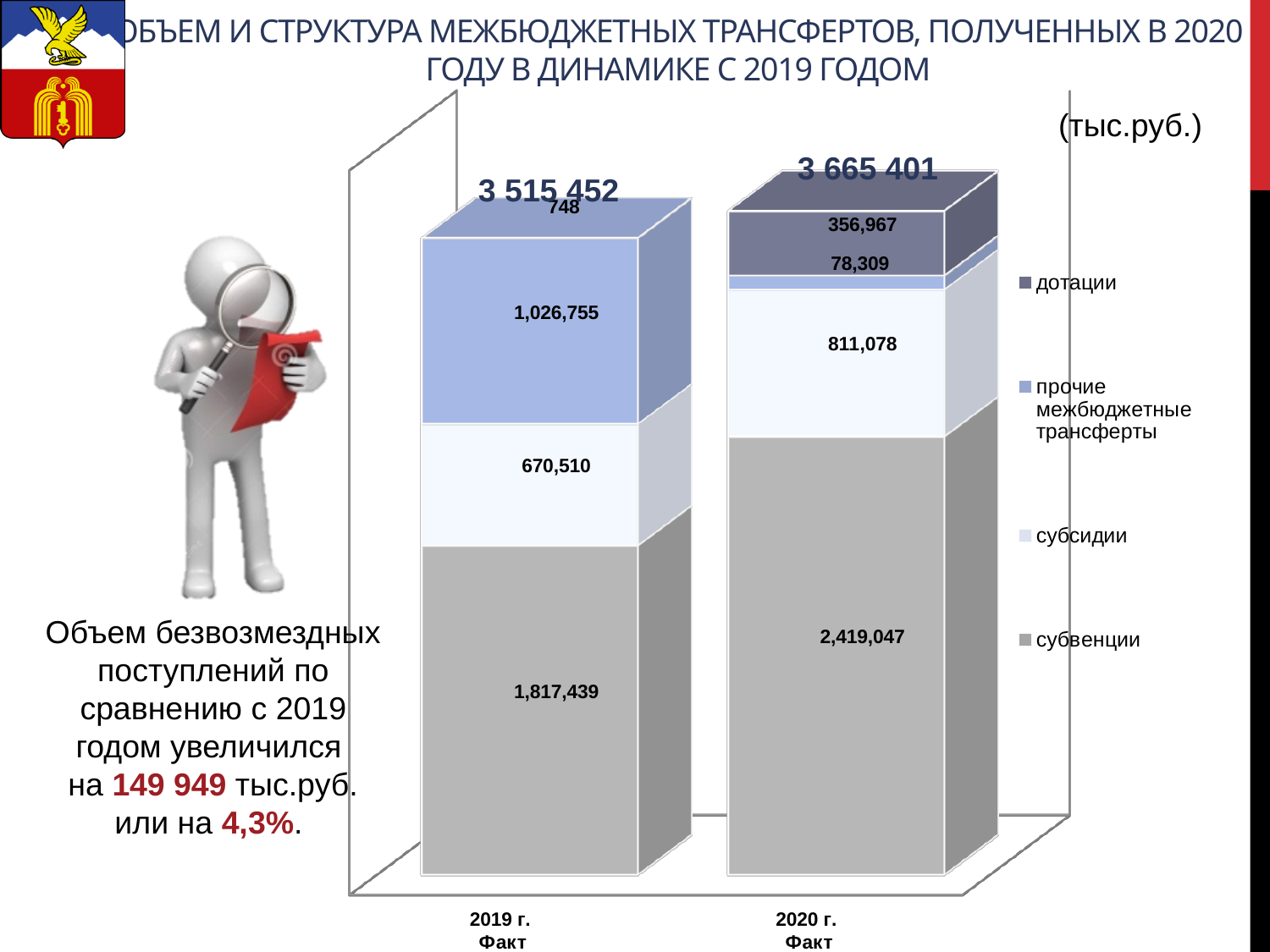
What type of chart is shown on the slide? stacked bar chart Which series has the largest value in the 2020 г. Факт bar? субвенции Which series has the smallest value in the 2019 г. Факт bar? дотации How many categories (bars) are shown on the x axis? 2 What is the value of субсидии for 2020 г. Факт? 811,078 What is the difference between the субвенции values for 2020 г. Факт and 2019 г. Факт? 601,608 What is the total of the stacked bar for 2020 г. Факт? 3 665 401 How many series does the legend list? 4 What is the value of прочие межбюджетные трансферты for 2019 г. Факт? 1,026,755 What is the value of субвенции for 2019 г. Факт? 1,817,439 What is the total of the stacked bar for 2019 г. Факт? 3 515 452 What is the value of дотации for 2020 г. Факт? 356,967